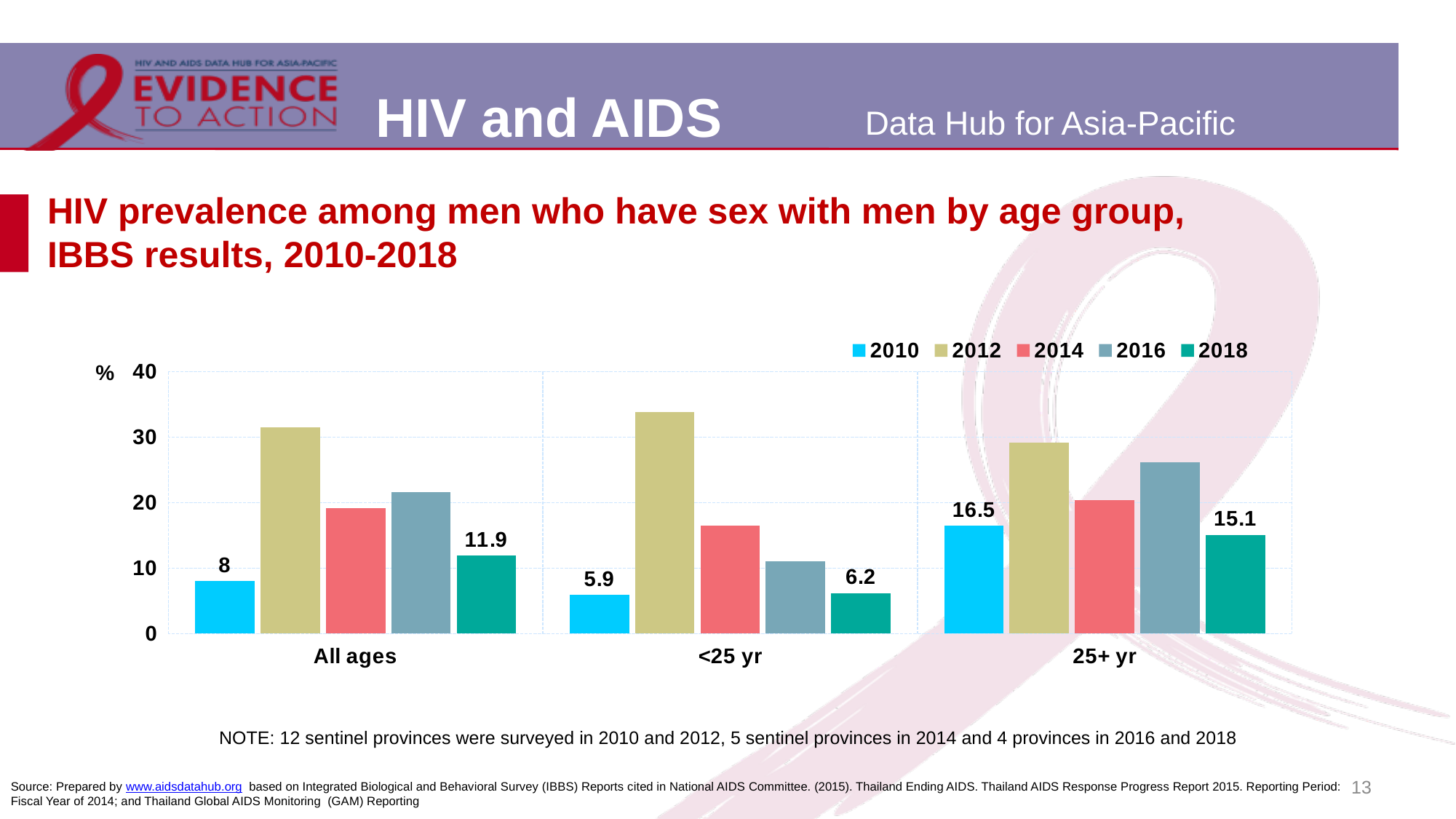
Is the 2012 value for the <25 yr group greater or less than 30? greater Is the 2016 value for the <25 yr group greater or less than 20? less Which age group has the lowest 2018 value? <25 yr How many years (series) does the legend list? 5 By how much does the 2018 value exceed the 2010 value in the All ages group? 3.9 What is the value for 2010 in the 25+ yr group? 16.5 Which age group has the highest 2010 value? 25+ yr What is the value for 2018 in the 25+ yr group? 15.1 How many age groups are shown on the x axis? 3 What is the HIV prevalence for 2010 in the All ages group? 8 In the 25+ yr group, which is larger: the 2010 value or the 2018 value? 2010 What is the value for 2018 in the <25 yr group? 6.2